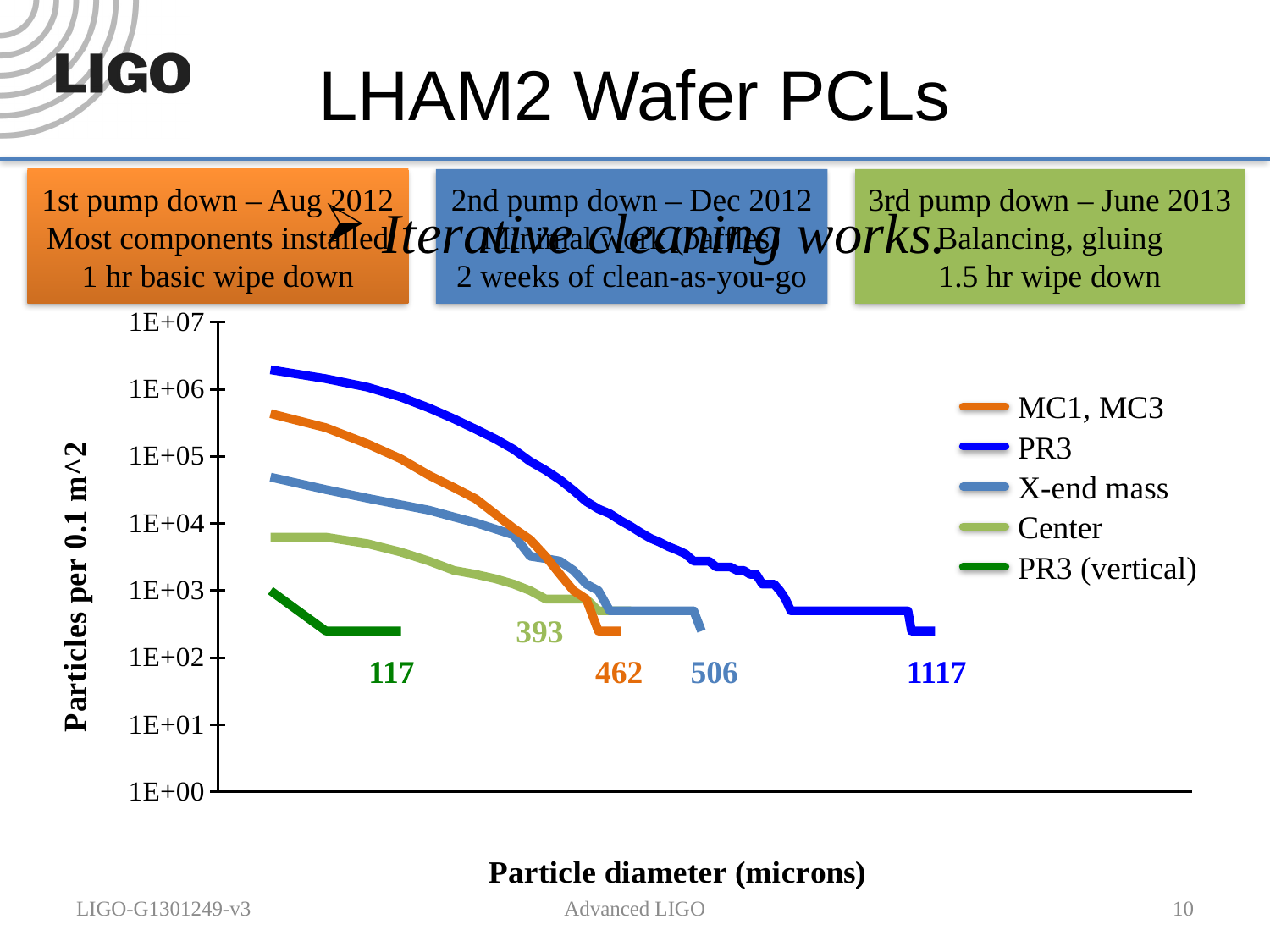
How many series does the chart legend list? 5 What kind of chart is shown on the slide? line chart What number is annotated in blue for the PR3 series on the chart? 1117 Which series has larger values at the left of the chart, PR3 or MC1, MC3? PR3 Which series has the highest values on the chart? PR3 Do the values of each series rise or fall as particle diameter increases along the x axis? fall Is the starting value of the PR3 series greater or less than 1E+06? greater What is the title of the chart's y axis? Particles per 0.1 m^2 Is the starting value of the X-end mass series greater or less than 1E+05? less Which series has the lowest values on the chart? PR3 (vertical) Is the starting value of the MC1, MC3 series greater or less than 1E+06? less What is the title of the chart's x axis? Particle diameter (microns)